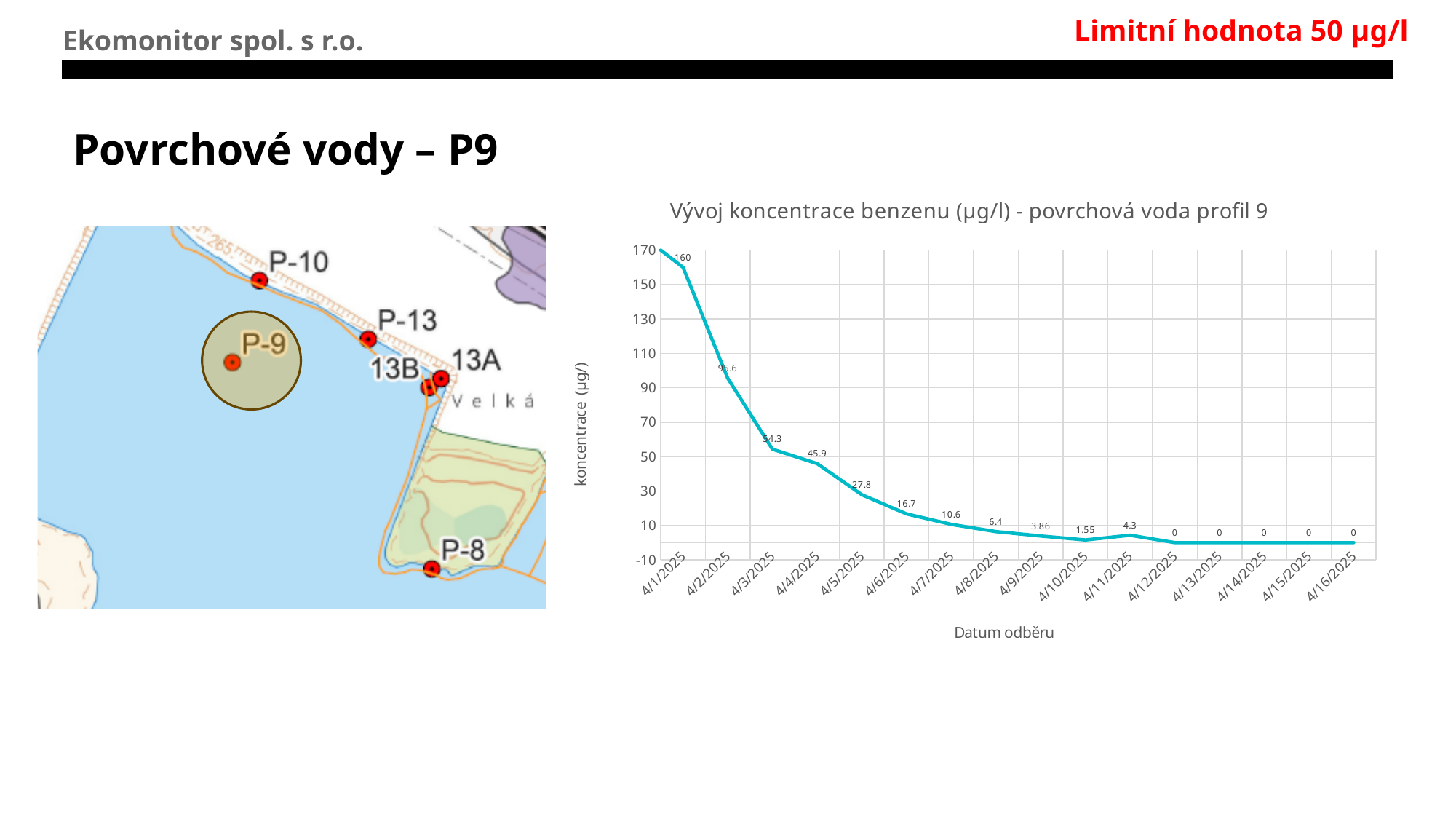
What is the difference between the concentrations on 4/1/2025 and 4/2/2025? 64.4 What is the benzene concentration on 4/3/2025? 54.3 What is the benzene concentration on 4/11/2025? 4.3 What is the difference between the concentrations on 4/5/2025 and 4/6/2025? 11.1 How many sampling dates are plotted on the x axis? 16 Is the value for 4/2/2025 greater or less than 90? greater What kind of chart is shown on the slide? line chart Which is larger, the concentration on 4/10/2025 or on 4/11/2025? 4/11/2025 Do the benzene concentrations generally rise or fall over the sampling dates? fall What is the benzene concentration on 4/1/2025? 160 What is the benzene concentration on 4/9/2025? 3.86 On which date is the benzene concentration highest? 4/1/2025